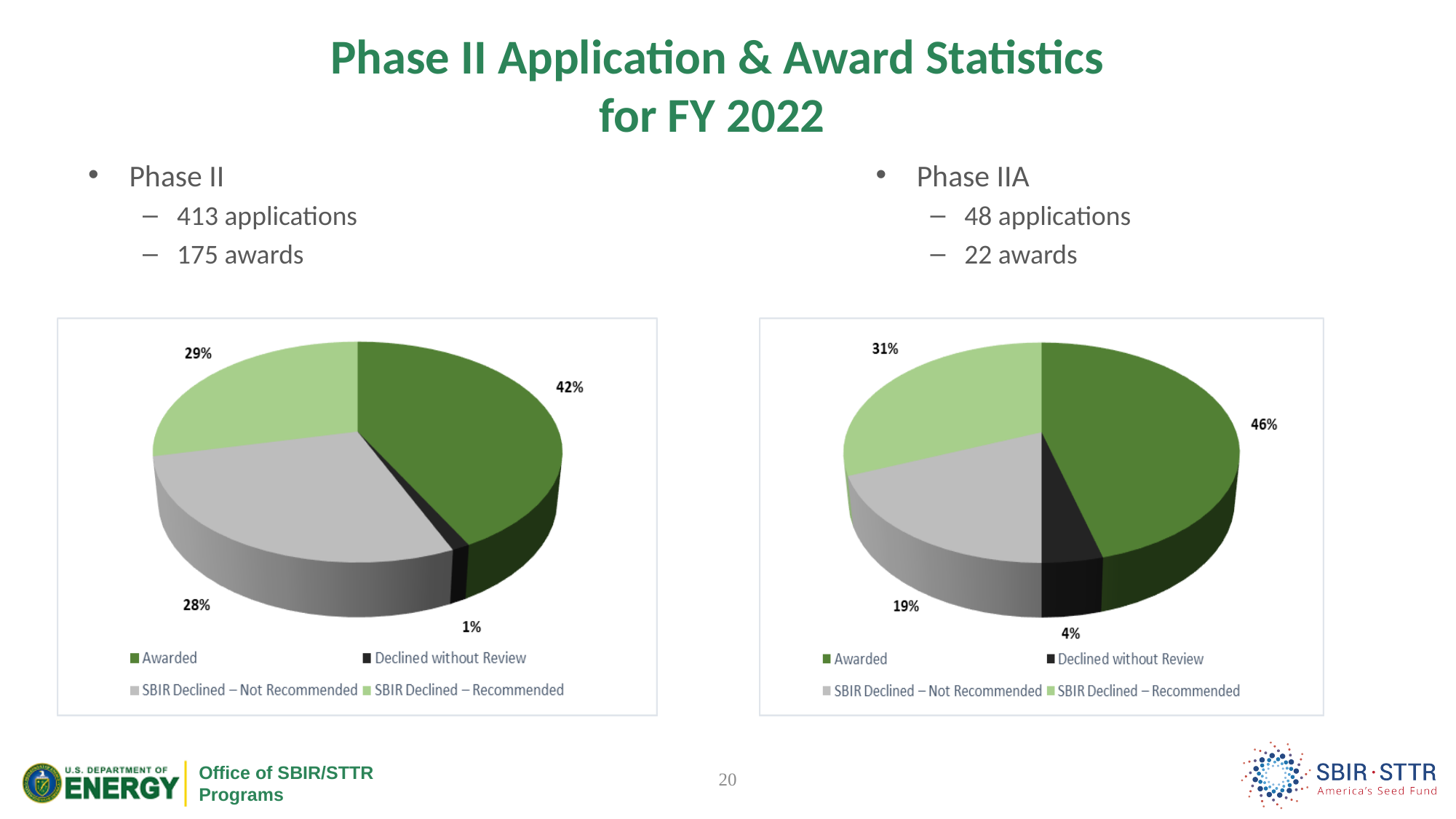
In the right pie chart (Phase IIA), what share is SBIR Declined – Not Recommended? 19% In the left pie chart (Phase II), what share is Awarded? 42% In the left pie chart (Phase II), what is the difference between the Awarded share and the SBIR Declined – Not Recommended share? 14% How many categories does the legend of the right pie chart (Phase IIA) list? 4 In the left pie chart (Phase II), which category has the smallest share? Declined without Review In the right pie chart (Phase IIA), what is the difference between the Awarded share and the Declined without Review share? 42% In the right pie chart (Phase IIA), which category has the largest share? Awarded In the left pie chart (Phase II), what share is Declined without Review? 1% Which chart shows a larger Awarded share, the left (Phase II) or the right (Phase IIA)? Right (Phase IIA) In the right pie chart (Phase IIA), what share is SBIR Declined – Recommended? 31% What type of chart is used on the left side of the slide? Pie chart In the left pie chart (Phase II), which is larger: SBIR Declined – Recommended or SBIR Declined – Not Recommended? SBIR Declined – Recommended